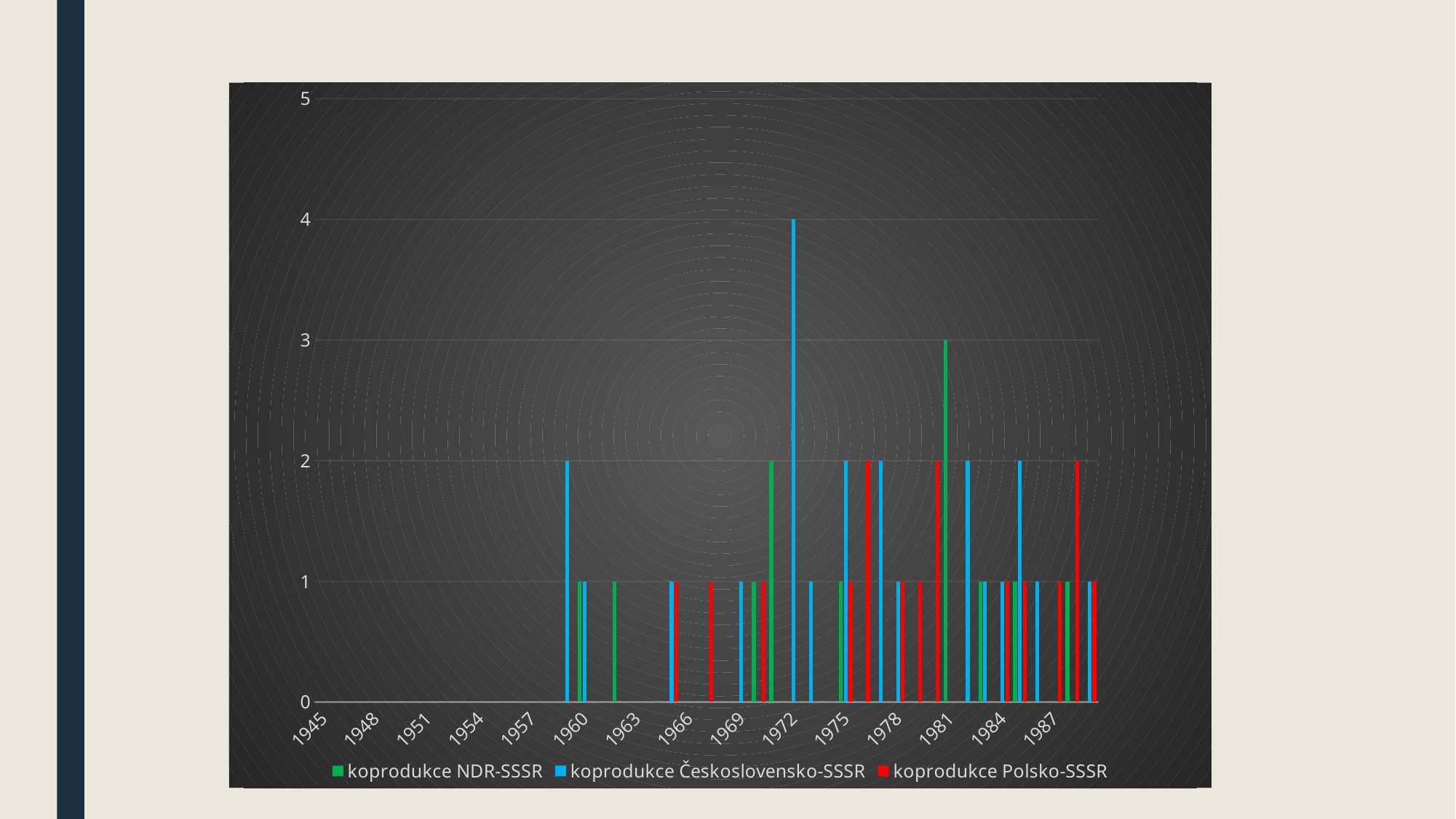
Which is larger: koprodukce Československo-SSSR in 1972 or koprodukce NDR-SSSR in 1981? koprodukce Československo-SSSR in 1972 How many series does the legend list? 3 What kind of chart is shown on the slide? bar chart Is the tallest bar in the chart greater or less than 3? greater What is the value for koprodukce Československo-SSSR in 1972? 4 What is the difference between the koprodukce Československo-SSSR value in 1972 and the koprodukce NDR-SSSR value in 1981? 1 Which series is shown in green in the legend? koprodukce NDR-SSSR What is the highest value reached by the koprodukce Polsko-SSSR series? 2 What is the highest value reached by the koprodukce Československo-SSSR series? 4 Which series has the tallest bar in the chart? koprodukce Československo-SSSR Which series is shown in red in the legend? koprodukce Polsko-SSSR What is the value for koprodukce NDR-SSSR in 1981? 3